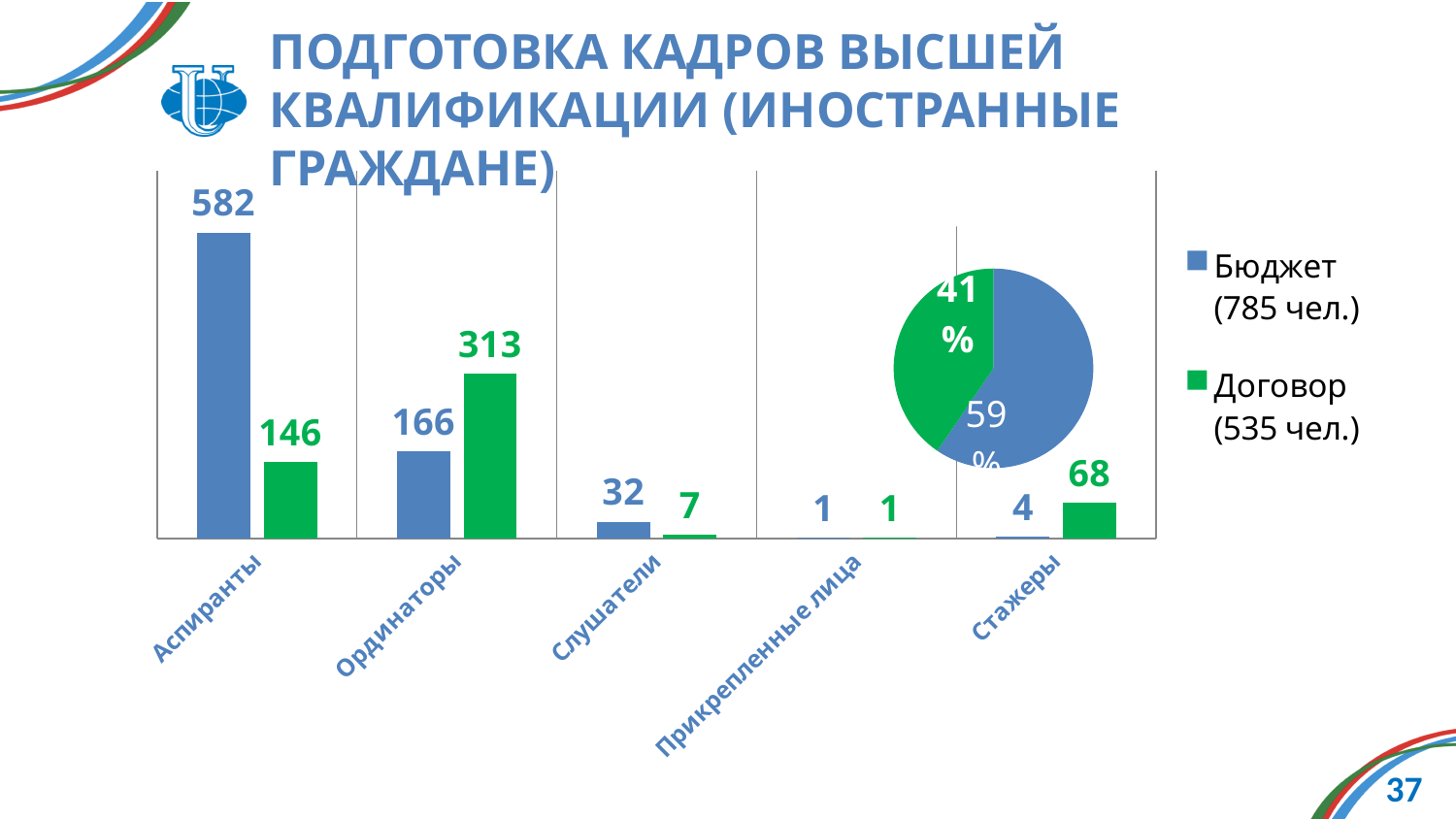
In the bar chart, what is the Договор value for Ординаторы? 313 According to the legend, how many people are in the Договор group? 535 чел. In the bar chart, which category has the highest Бюджет value? Аспиранты In the bar chart, which is larger for Ординаторы: Бюджет or Договор? Договор In the bar chart, what is the difference between the Бюджет and Договор values for Аспиранты? 436 In the pie chart, what share does the Бюджет slice have? 59% What kind of chart is the large chart with the category labels along the bottom? Bar chart How many categories are shown on the x axis of the bar chart? 5 In the bar chart, what is the Договор value for Стажеры? 68 How many series does the legend list? 2 In the bar chart, which category has the lowest Договор value? Прикрепленные лица In the bar chart, what is the Бюджет value for Аспиранты? 582